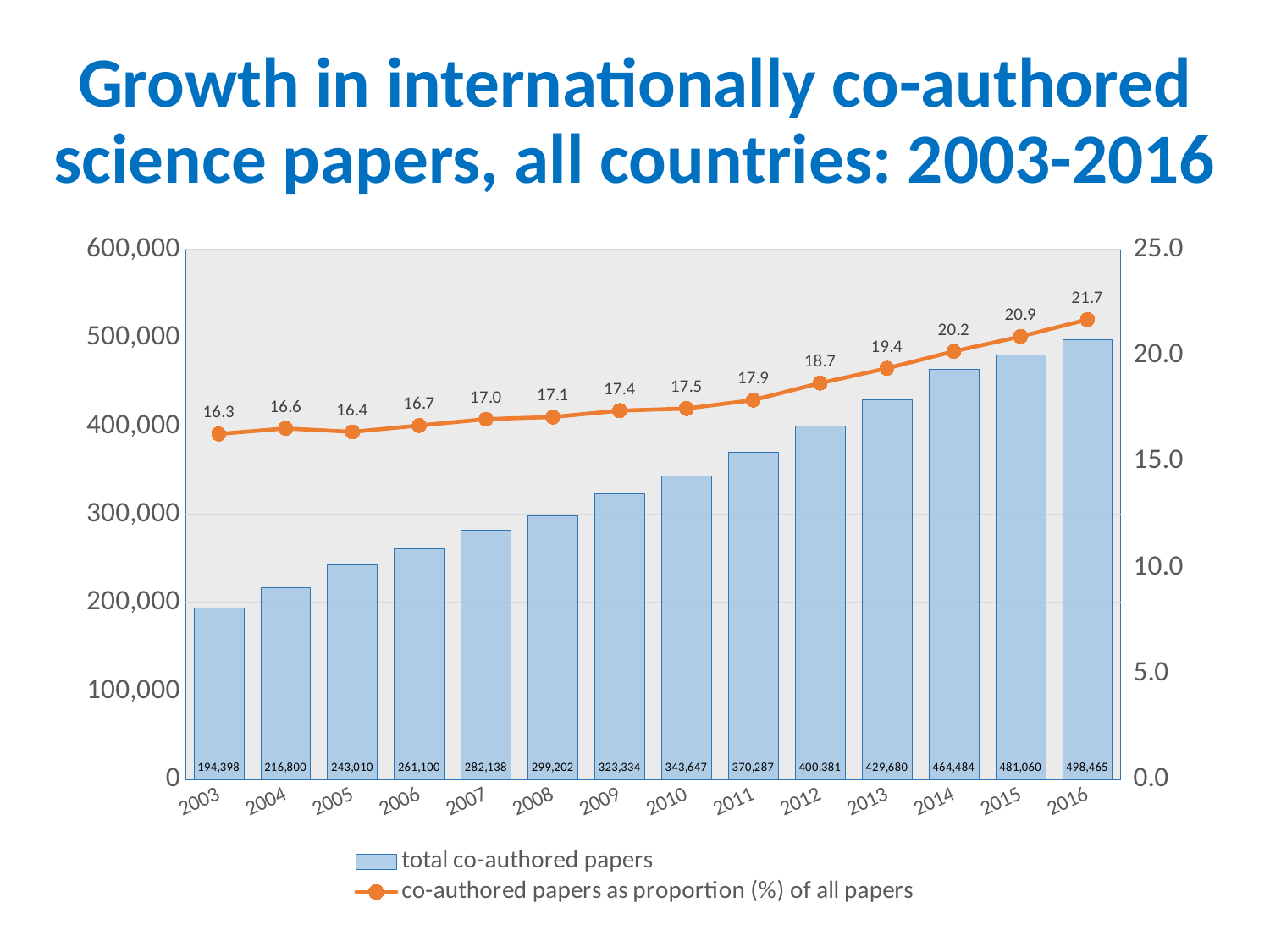
Do the values for total co-authored papers rise or fall from 2003 to 2016? rise What kind of chart is used for the total co-authored papers series? bar chart Which year has the highest value of total co-authored papers? 2016 What is the value of total co-authored papers in 2010? 343,647 Which year has a higher proportion of co-authored papers, 2004 or 2005? 2004 What is the co-authored papers as proportion (%) of all papers in 2012? 18.7 What is the title of the chart? Growth in internationally co-authored science papers, all countries: 2003-2016 How many years are shown on the x axis? 14 How many series does the legend list? 2 Which year has the lowest co-authored papers as proportion (%) of all papers? 2003 What is the difference in total co-authored papers between 2016 and 2003? 304,067 Is the value for total co-authored papers in 2008 greater or less than 300,000? less